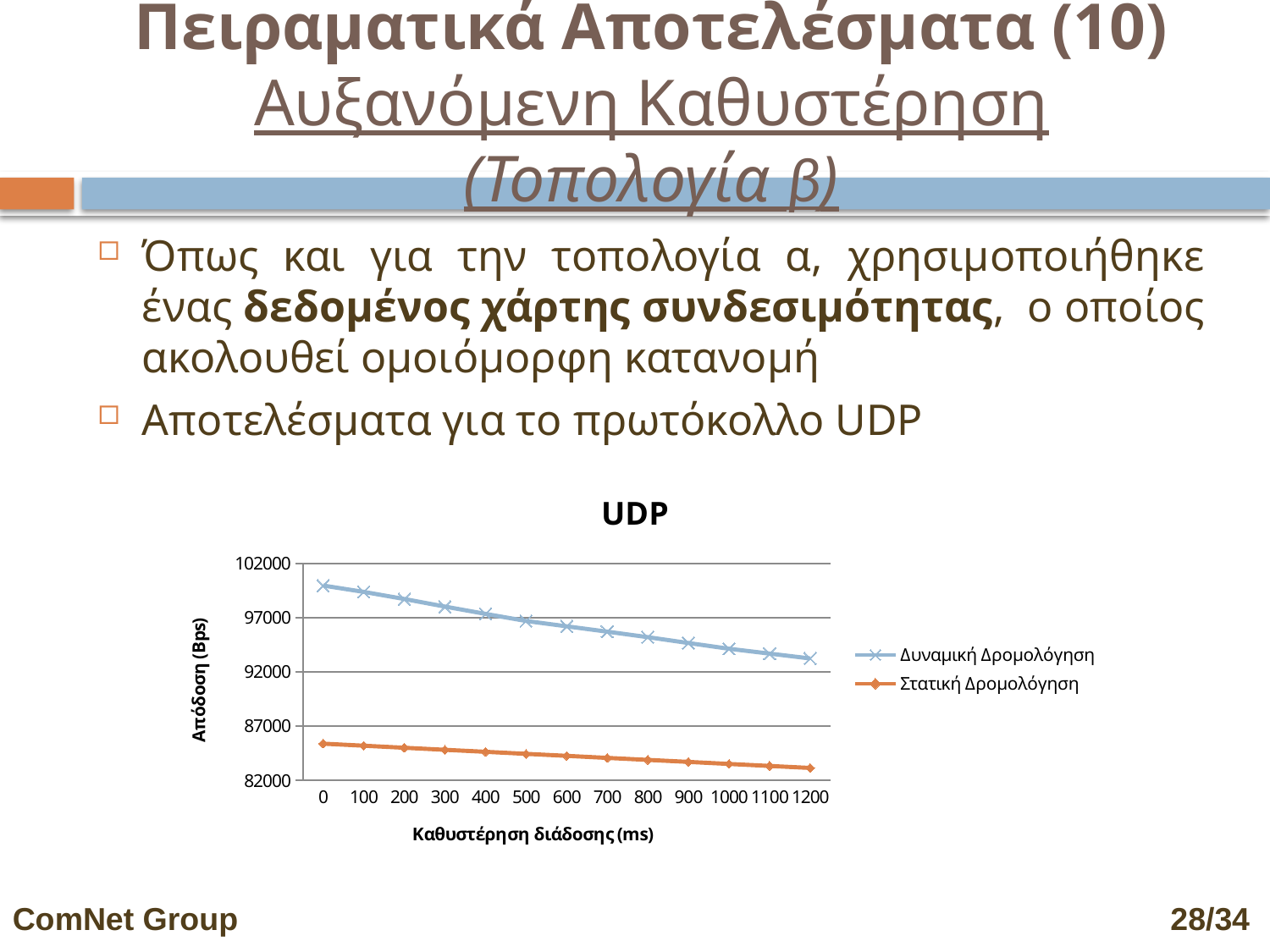
Is the value for Στατική Δρομολόγηση at 1200 ms greater or less than 82000? greater Do the values of the Στατική Δρομολόγηση series rise or fall as the delay increases along the x axis? fall How many points are plotted along the x axis for each series? 13 How many series does the chart legend list? 2 What is the label of the x axis of the chart? Καθυστέρηση διάδοσης (ms) What is the title of the chart? UDP What kind of chart is shown on the slide? line chart Which series has the higher values across the whole chart, Δυναμική Δρομολόγηση or Στατική Δρομολόγηση? Δυναμική Δρομολόγηση Is the value for Δυναμική Δρομολόγηση at 1200 ms greater or less than 92000? greater Is the value for Στατική Δρομολόγηση at 0 ms greater or less than 87000? less Do the values of the Δυναμική Δρομολόγηση series rise or fall as the delay increases along the x axis? fall